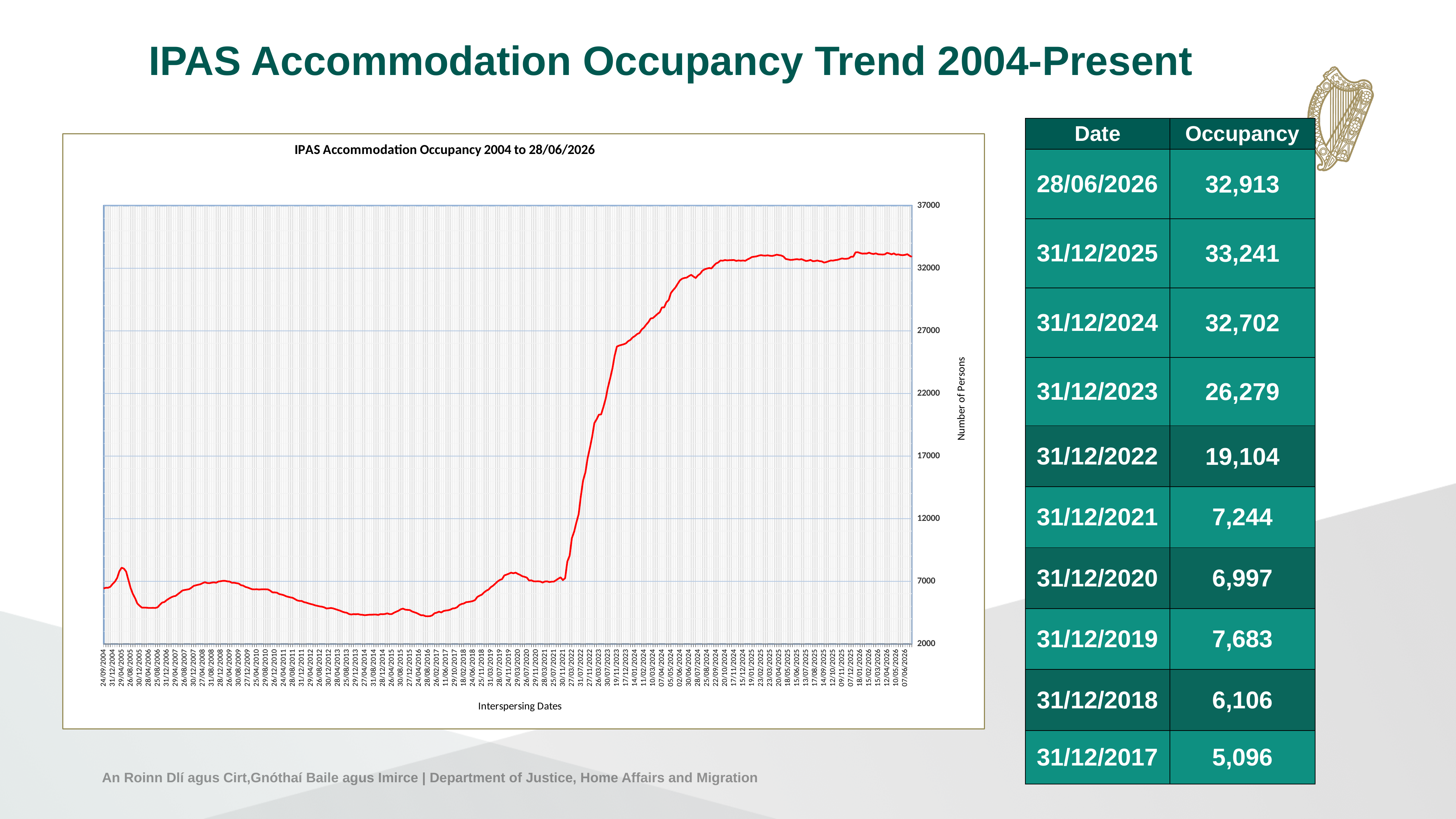
What is the title of the chart? IPAS Accommodation Occupancy 2004 to 28/06/2026 Is the occupancy value at 24/09/2004 greater or less than 7000? less What kind of chart is shown on the slide? line chart What is the difference in occupancy between 31/12/2023 and 31/12/2022 in the table? 7,175 Which date in the table has the highest occupancy? 31/12/2025 According to the table beside the chart, what was the occupancy on 31/12/2022? 19,104 According to the table beside the chart, what was the occupancy on 28/06/2026? 32,913 Is the occupancy value at 28/08/2016 greater or less than 7000? less Overall, does the occupancy line rise or fall from 2004 to 2026? rise What is the label of the vertical axis of the chart? Number of Persons Which date in the table has the lowest occupancy? 31/12/2017 Is the occupancy value at 07/06/2026 greater or less than 32000? greater